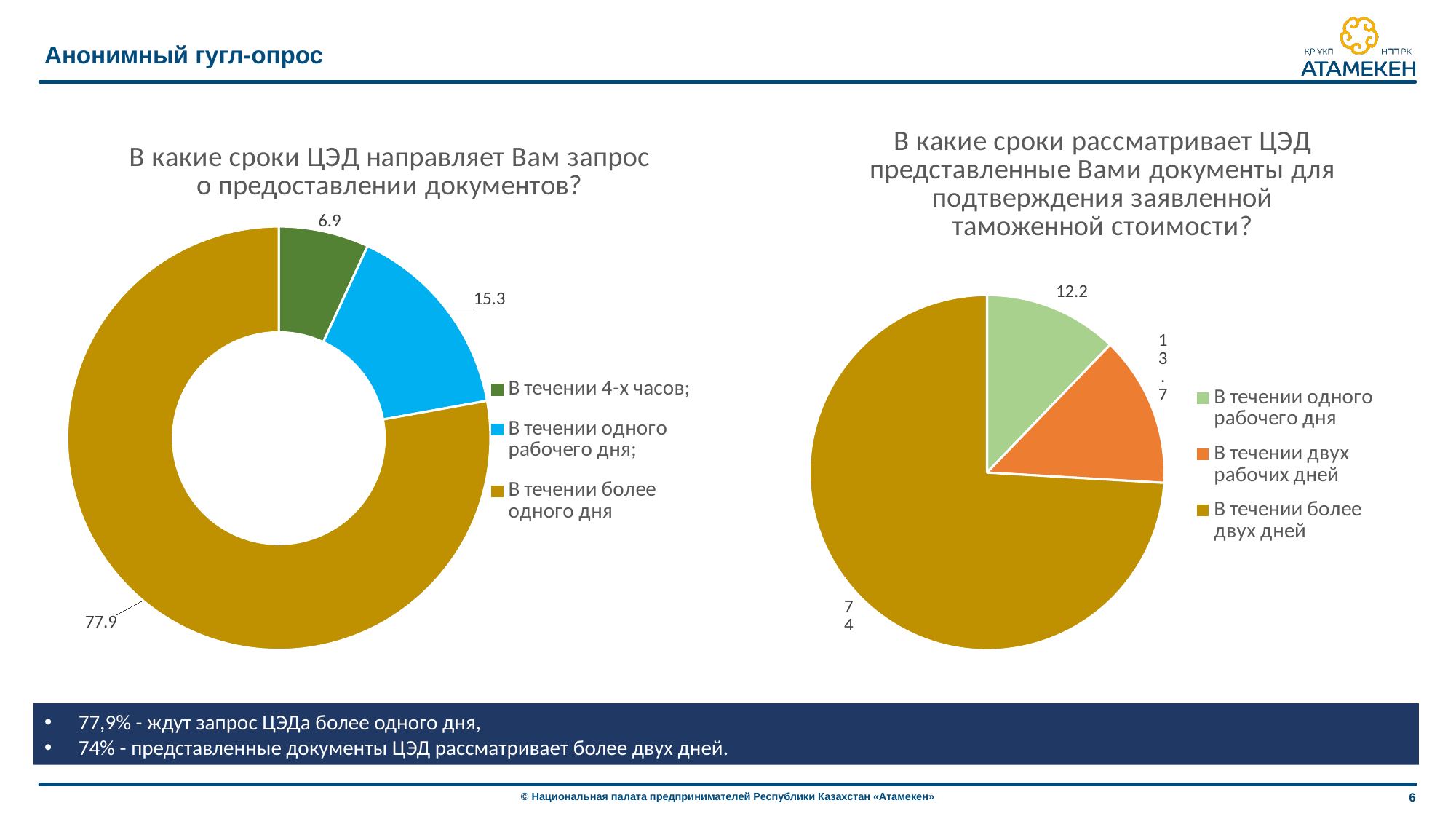
In the left chart, which category has the smallest value? В течении 4-х часов In the left chart, what is the value for 'В течении 4-х часов'? 6.9 In the left chart, what is the value for 'В течении более одного дня'? 77.9 In the left chart, what is the difference between the values for 'В течении одного рабочего дня' and 'В течении 4-х часов'? 8.4 In the right chart, which is larger: 'В течении двух рабочих дней' or 'В течении одного рабочего дня'? В течении двух рабочих дней In the right chart, which category has the largest value? В течении более двух дней In the left chart, what is the value for 'В течении одного рабочего дня'? 15.3 How many categories does the right chart's legend list? 3 In the right chart, what is the value for 'В течении одного рабочего дня'? 12.2 In the right chart, what colour is the slice for 'В течении двух рабочих дней'? Orange What kind of chart is the left chart? Donut (pie) chart In the right chart, what is the value for 'В течении более двух дней'? 74